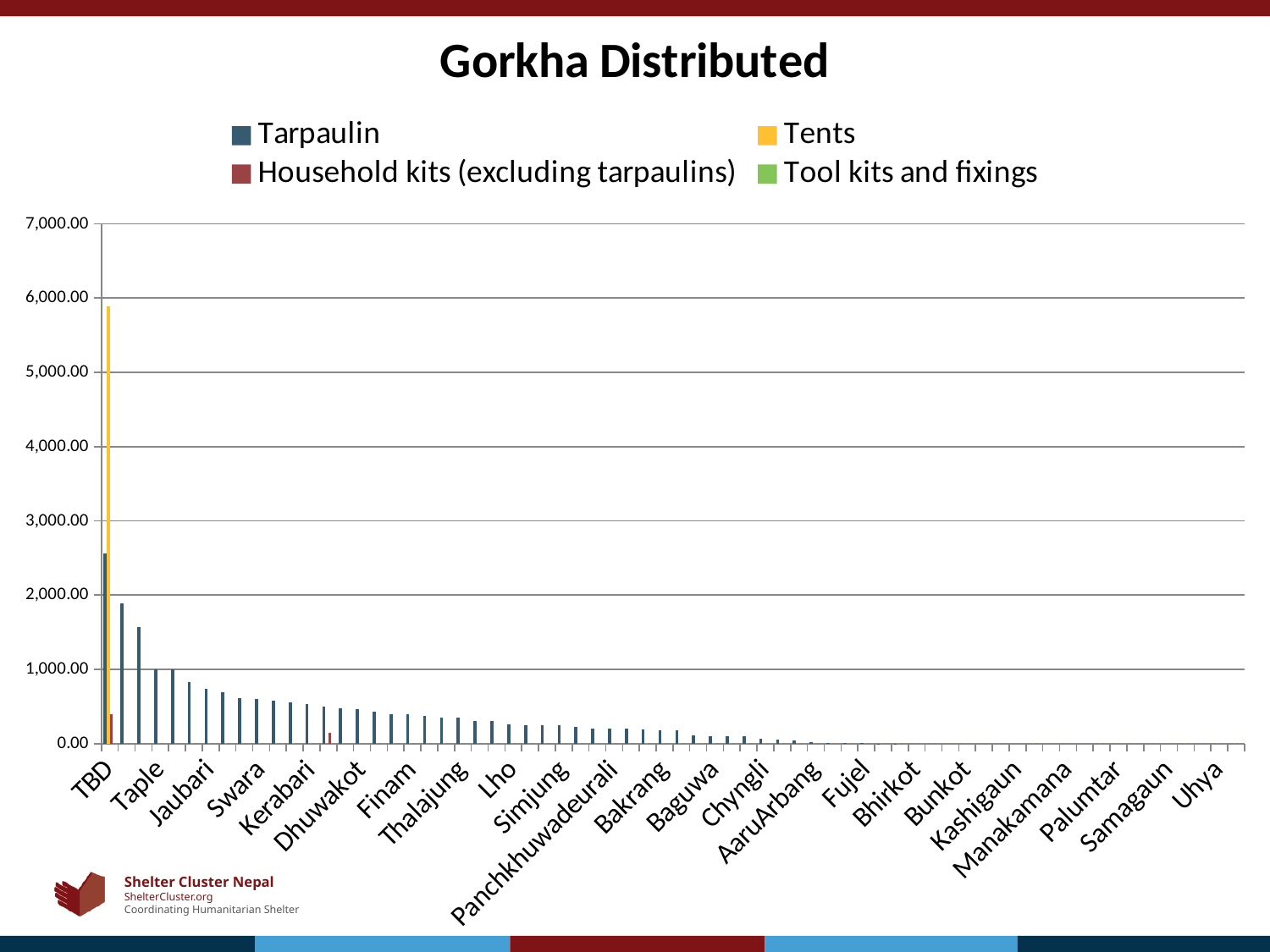
Is the Tarpaulin value for Swara greater or less than 1,000.00? less Which series is shown in yellow in the legend? Tents Which category has the tallest bar on the chart? TBD Which has the larger Tarpaulin value, Taple or Kerabari? Taple What kind of chart is shown on the slide? bar chart Is the Tents value for TBD greater or less than 5,000.00? greater Which series has the tallest bar for TBD? Tents Do the Tarpaulin values generally rise or fall from left to right along the x axis? fall What is the title of the chart? Gorkha Distributed How many series does the legend list? 4 Is the Tarpaulin value for TBD greater or less than 2,000.00? greater